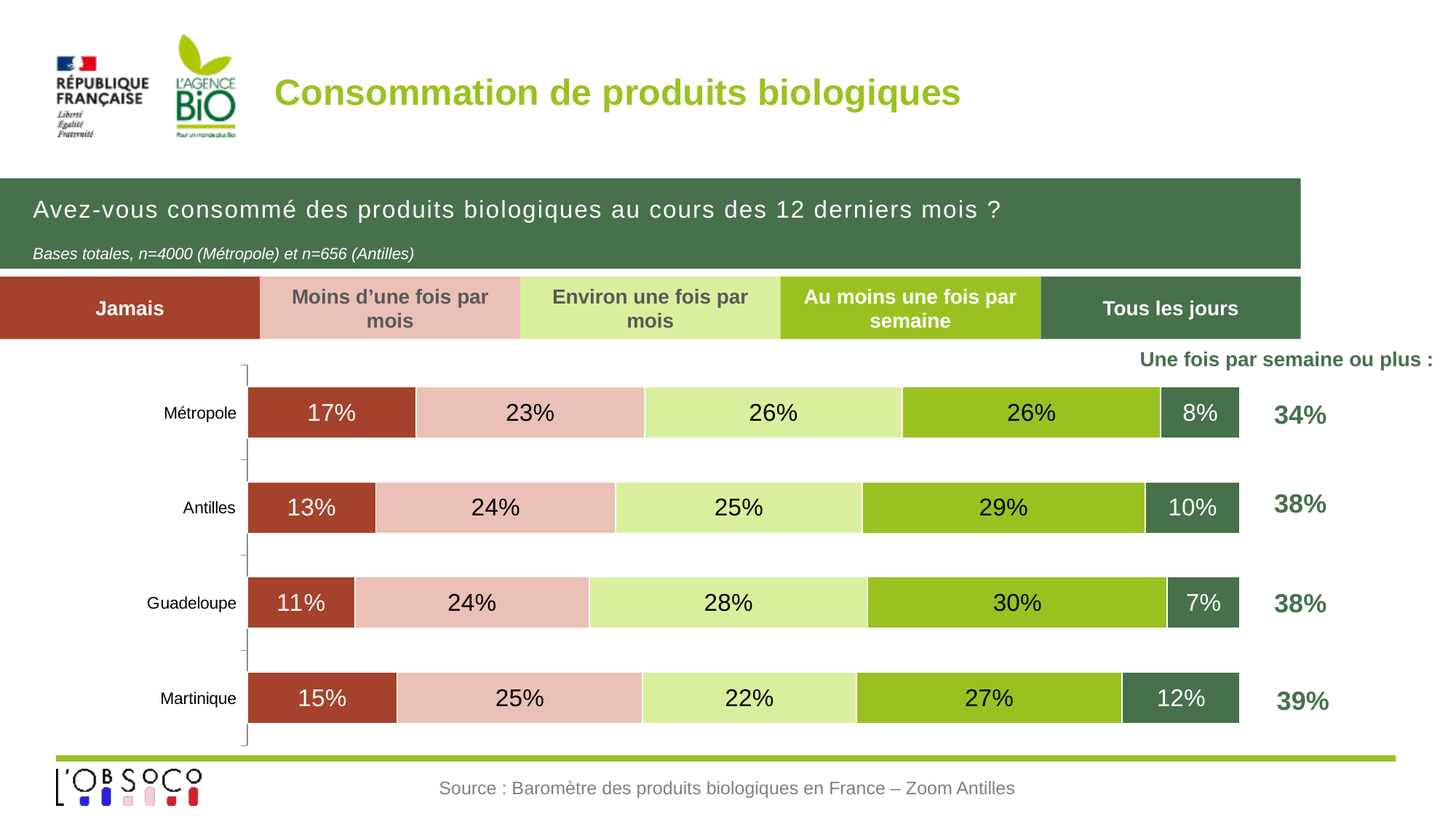
What is the difference between the "Au moins une fois par semaine" values for Guadeloupe and Métropole? 4 percentage points Which colour represents the "Jamais" category in the legend? Dark red / brick red What is the "Jamais" value for Guadeloupe? 11% What percentage of respondents in Martinique answered "Tous les jours"? 12% How many regions are shown in the chart? 4 What is the "Au moins une fois par semaine" value for Antilles? 29% What is the "Une fois par semaine ou plus" total shown for Martinique? 39% Which is larger, the "Environ une fois par mois" value for Guadeloupe or for Martinique? Guadeloupe What kind of chart is shown on the slide? Stacked bar chart Which region has the lowest "Tous les jours" value? Guadeloupe Which region has the highest "Jamais" value? Métropole How many response categories does the legend list? 5